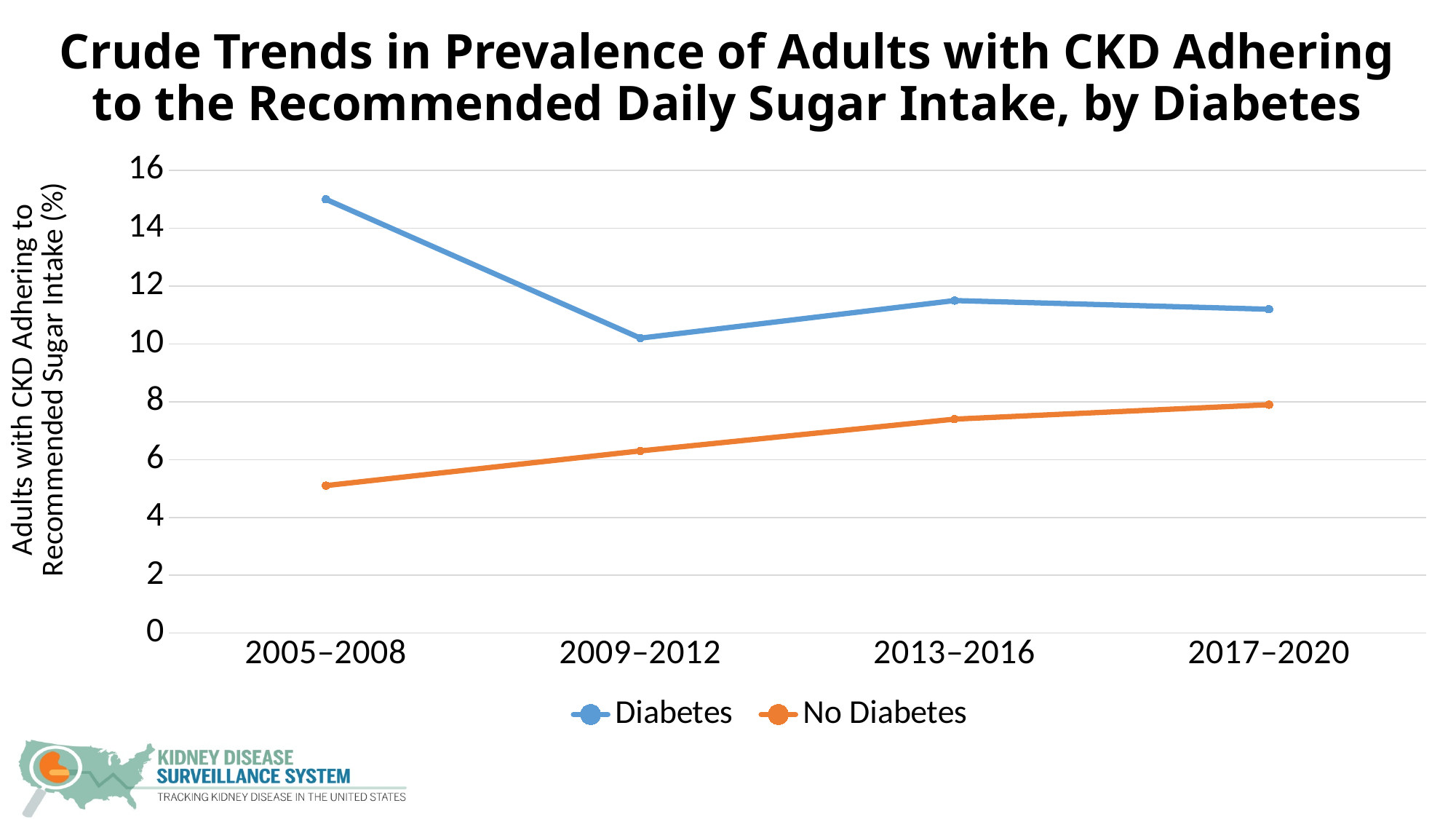
In which period is the No Diabetes series lowest? 2005–2008 How many time periods are shown on the x axis? 4 What kind of chart is shown on the slide? line chart In which period is the Diabetes series highest? 2005–2008 In which period is the Diabetes series lowest? 2009–2012 How many series does the legend list? 2 Is the value for Diabetes in 2005–2008 greater or less than 14? greater Does the No Diabetes series rise or fall from 2005–2008 to 2017–2020? rise Is the value for No Diabetes in 2017–2020 greater or less than 6? greater Is the value for No Diabetes in 2005–2008 greater or less than 6? less Which series has the higher value in 2017–2020, Diabetes or No Diabetes? Diabetes